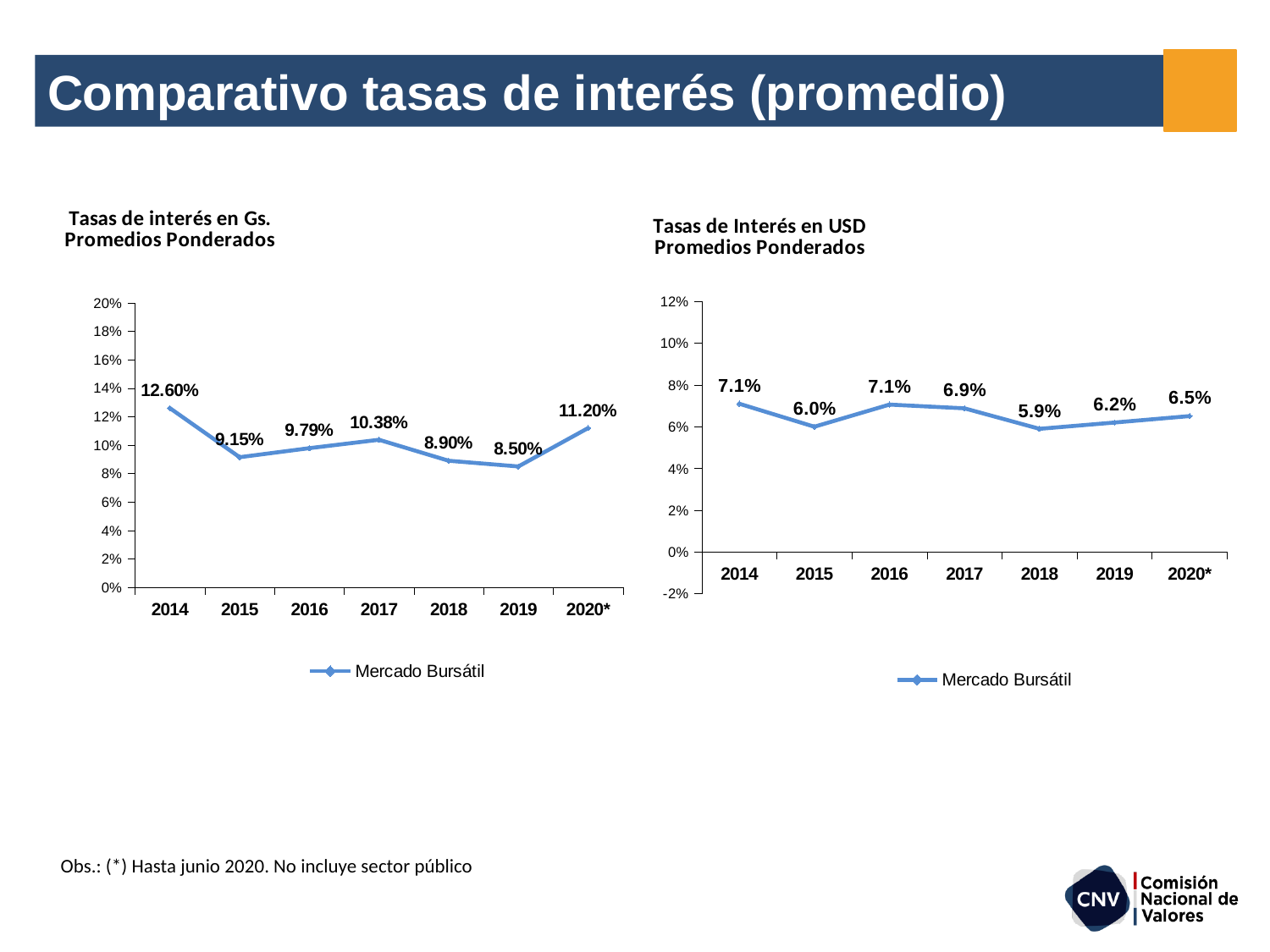
In the 'Tasas de Interés en USD Promedios Ponderados' chart, which year has the lowest value? 2018 What kind of chart is the 'Tasas de Interés en USD Promedios Ponderados' chart? line chart In the 'Tasas de interés en Gs. Promedios Ponderados' chart, how many years are plotted? 7 In the 'Tasas de interés en Gs. Promedios Ponderados' chart, what is the difference between the 2014 value and the 2015 value? 3.45% In the 'Tasas de Interés en USD Promedios Ponderados' chart, what is the difference between the 2016 value and the 2015 value? 1.1% In the 'Tasas de Interés en USD Promedios Ponderados' chart, what is the value for 2018? 5.9% In the 'Tasas de Interés en USD Promedios Ponderados' chart, is the value for 2015 larger or smaller than the value for 2019? smaller In the 'Tasas de interés en Gs. Promedios Ponderados' chart, what is the value for 2017? 10.38% In the 'Tasas de interés en Gs. Promedios Ponderados' chart, which year has the highest value? 2014 In the 'Tasas de Interés en USD Promedios Ponderados' chart, what is the value for 2020*? 6.5% In the 'Tasas de interés en Gs. Promedios Ponderados' chart, which year has the lowest value? 2019 What series name does the legend of the 'Tasas de interés en Gs. Promedios Ponderados' chart show? Mercado Bursátil